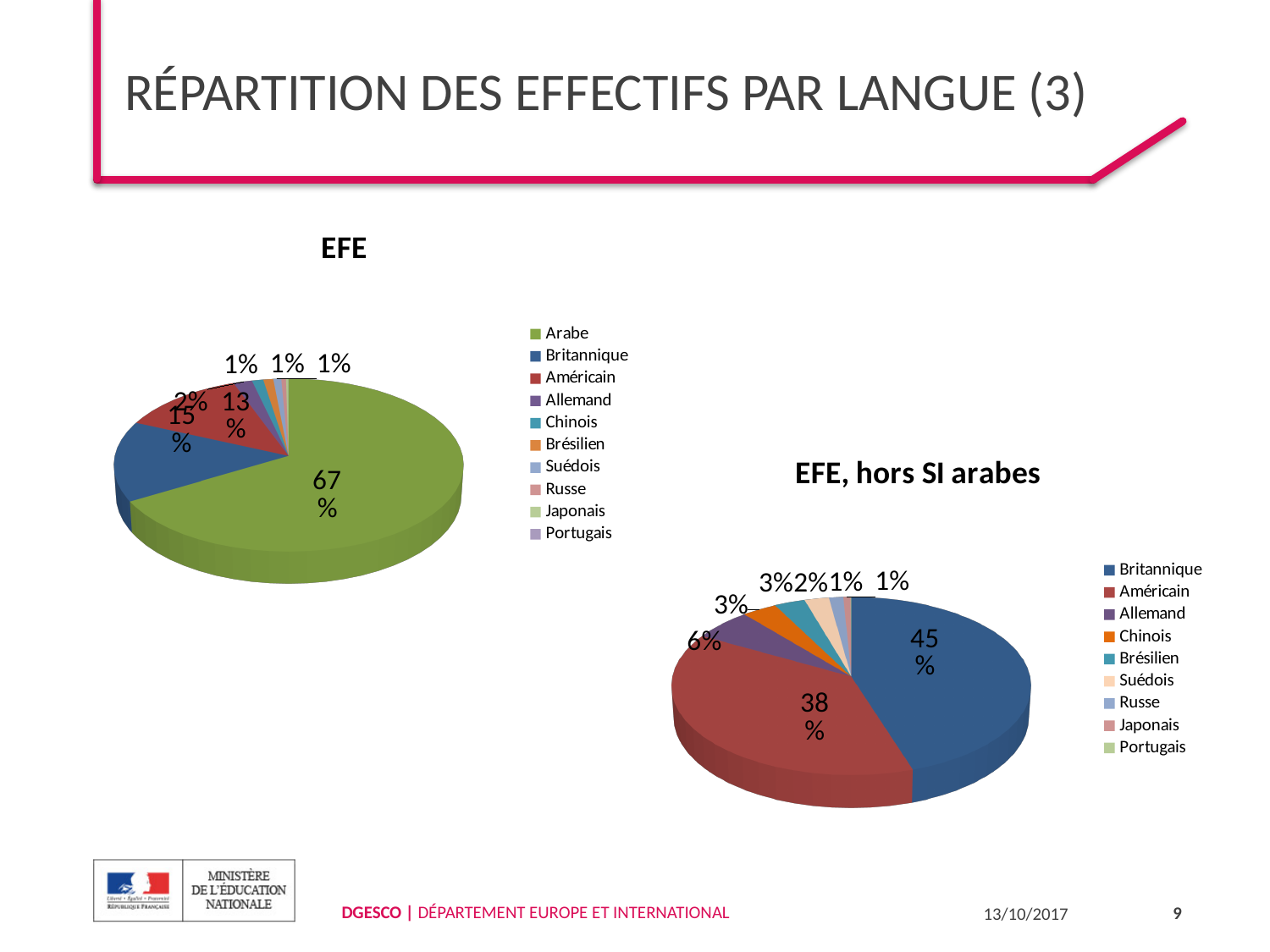
In the 'EFE' chart, how many percentage points larger is Britannique than Américain? 2 percentage points In the 'EFE' chart, what share of the pie does Arabe represent? 67% In the 'EFE' chart, which language has the largest slice? Arabe In the 'EFE, hors SI arabes' chart, what percentage is shown for Allemand? 6% In the 'EFE, hors SI arabes' chart, which language has the largest slice? Britannique In the 'EFE, hors SI arabes' chart, what percentage is shown for Britannique? 45% In the 'EFE, hors SI arabes' chart, what percentage is shown for Américain? 38% In the 'EFE' chart, what percentage is shown for Américain? 13% What type of chart is the 'EFE, hors SI arabes' chart? Pie chart In the 'EFE, hors SI arabes' chart, what is the difference in percentage points between Britannique and Américain? 7 percentage points How many entries does the legend of the 'EFE' chart list? 10 In the 'EFE' chart, what percentage is shown for Britannique? 15%